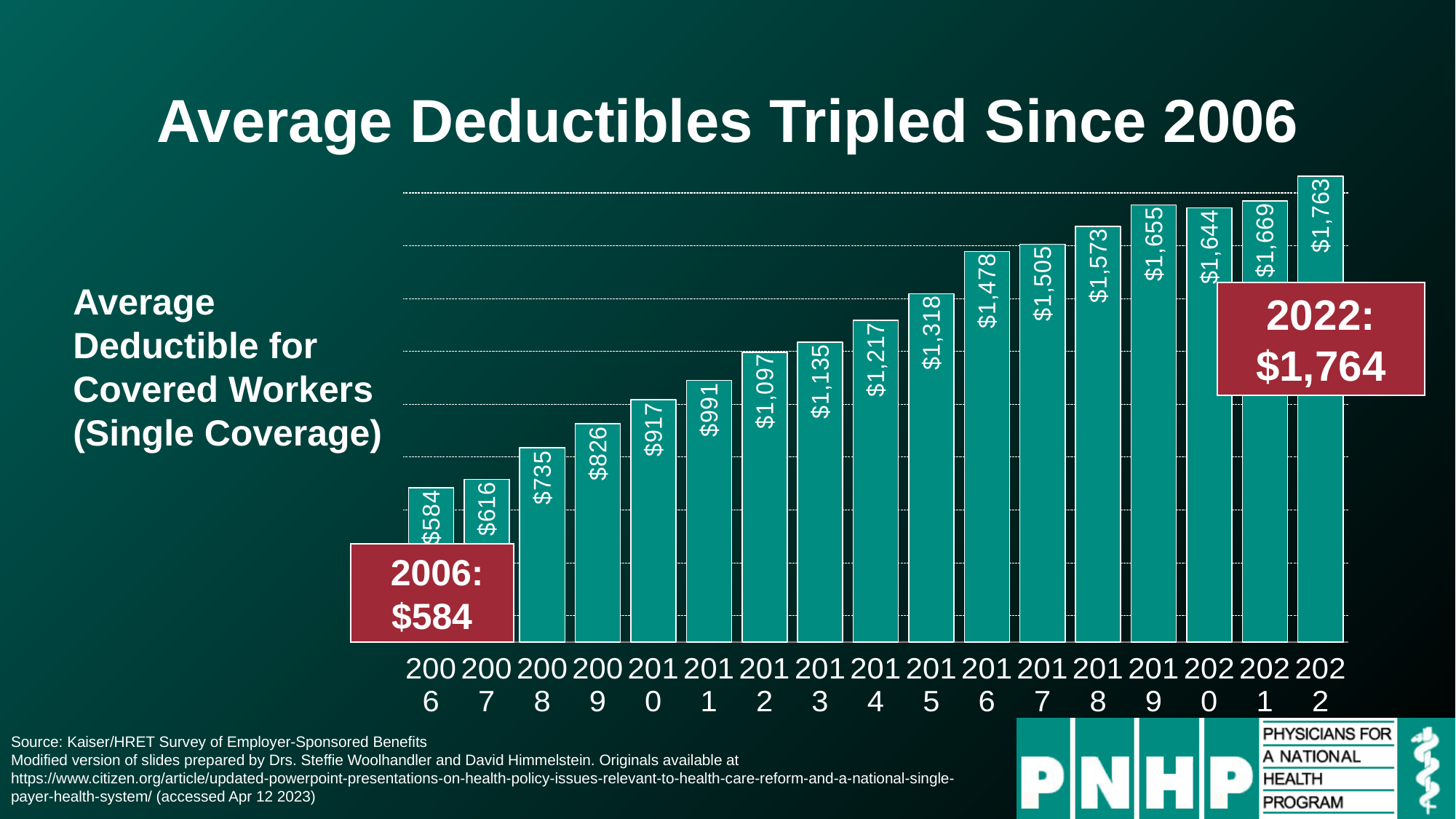
What was the average deductible in 2017? $1,505 What is the title of the slide containing the chart? Average Deductibles Tripled Since 2006 What was the average deductible in 2020? $1,644 How many years are shown on the x axis of the chart? 17 Do the average deductibles generally rise or fall from 2006 to 2022? Rise What is the difference between the average deductible in 2010 and in 2009? $91 Which year has the lowest average deductible? 2006 What was the average deductible for covered workers in 2006? $584 Which year had a higher average deductible, 2019 or 2020? 2019 Which year has the highest average deductible? 2022 What type of chart is shown on the slide? Bar chart What was the average deductible in 2012? $1,097